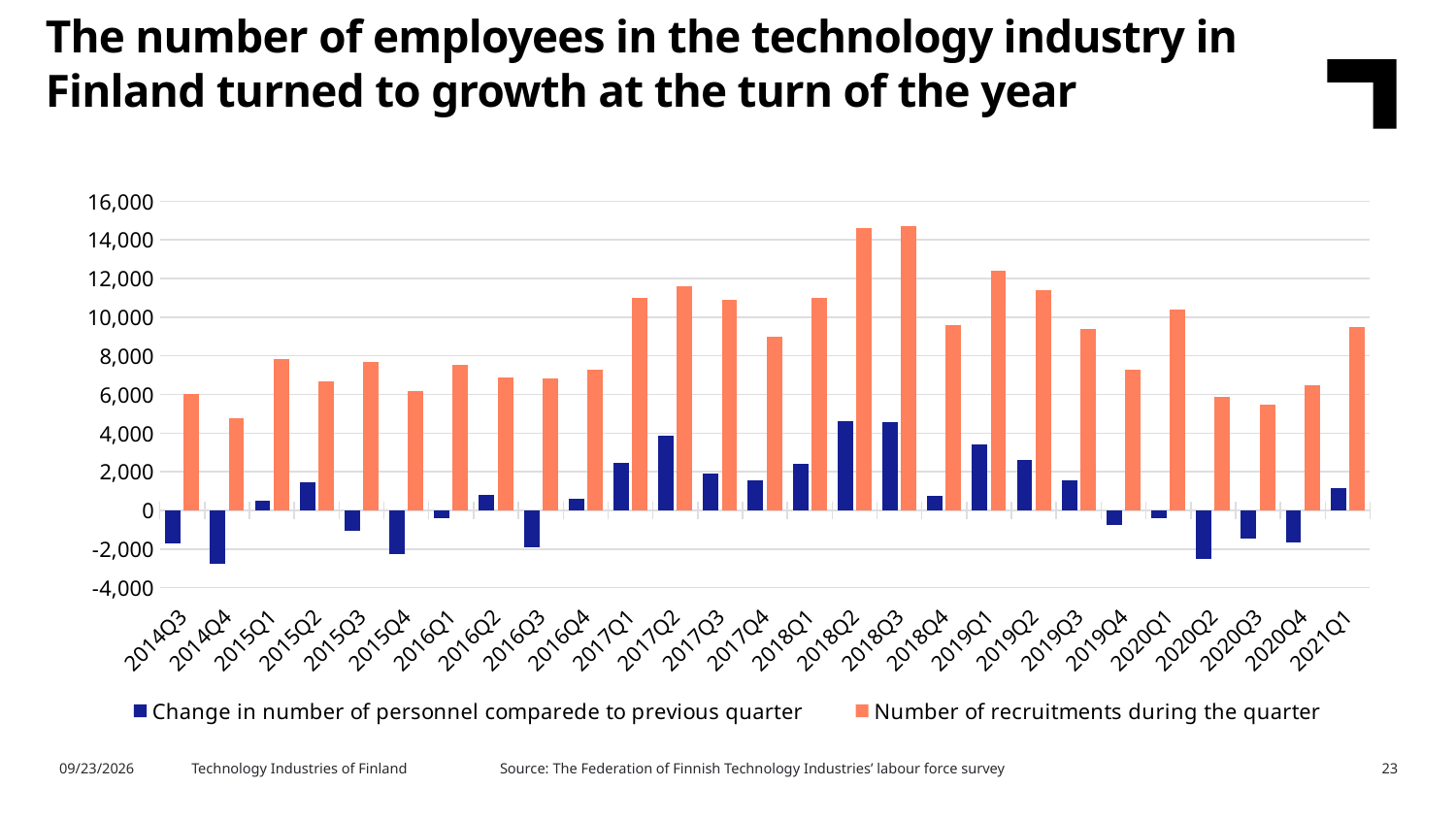
How many quarters are shown on the x axis? 27 Is the change in number of personnel compared to previous quarter for 2014Q4 greater or less than -2,000? less Is the change in number of personnel compared to previous quarter for 2019Q1 greater or less than 2,000? greater Which quarter has the lowest number of recruitments during the quarter? 2014Q4 Is the number of recruitments during the quarter for 2018Q3 greater or less than 14,000? greater What kind of chart is shown on the slide? Bar chart Which quarter has the higher number of recruitments during the quarter, 2019Q1 or 2020Q1? 2019Q1 How many series does the legend list? 2 Which quarter has the larger change in number of personnel compared to previous quarter, 2020Q2 or 2021Q1? 2021Q1 Does the number of recruitments during the quarter rise or fall from 2020Q3 to 2021Q1? Rise